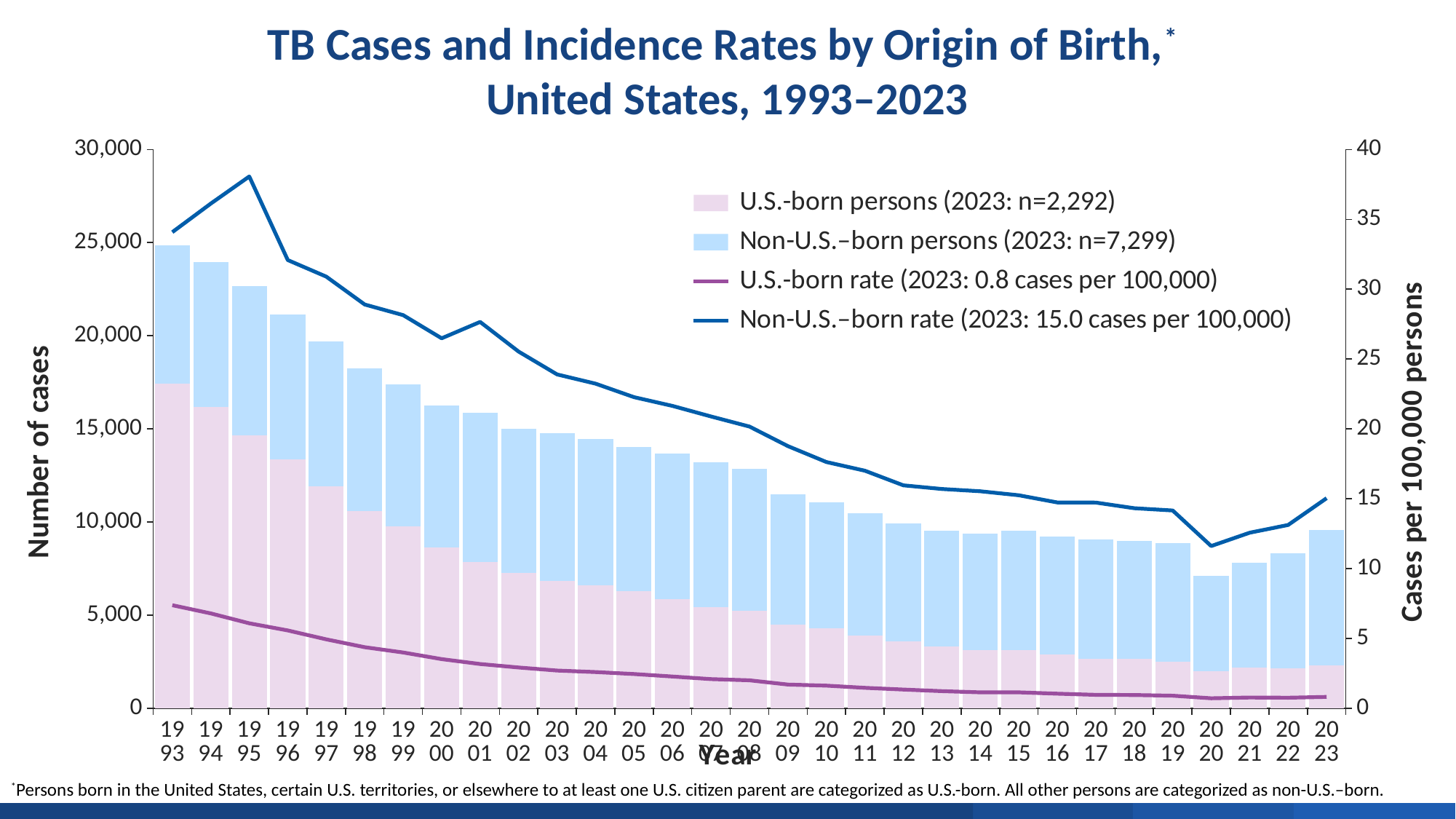
What is the 2023 U.S.-born TB incidence rate shown in the legend? 0.8 cases per 100,000 How many TB cases among U.S.-born persons does the legend report for 2023? 2,292 How many series does the legend list? 4 What is the 2023 non-U.S.-born TB incidence rate shown in the legend? 15.0 cases per 100,000 How many TB cases among non-U.S.-born persons does the legend report for 2023? 7,299 In which year is the total stacked bar of TB cases the lowest? 2020 What is the total number of TB cases in 2023 (U.S.-born plus non-U.S.-born)? 9,591 In which year does the non-U.S.-born rate line reach its highest point? 1995 Is the non-U.S.-born rate in 1995 greater or less than 35 cases per 100,000 persons? greater Is the total number of TB cases in 2020 greater or less than 10,000? less In 2023, which group had more TB cases, U.S.-born persons or non-U.S.-born persons? Non-U.S.-born persons How many years are shown along the x axis? 31